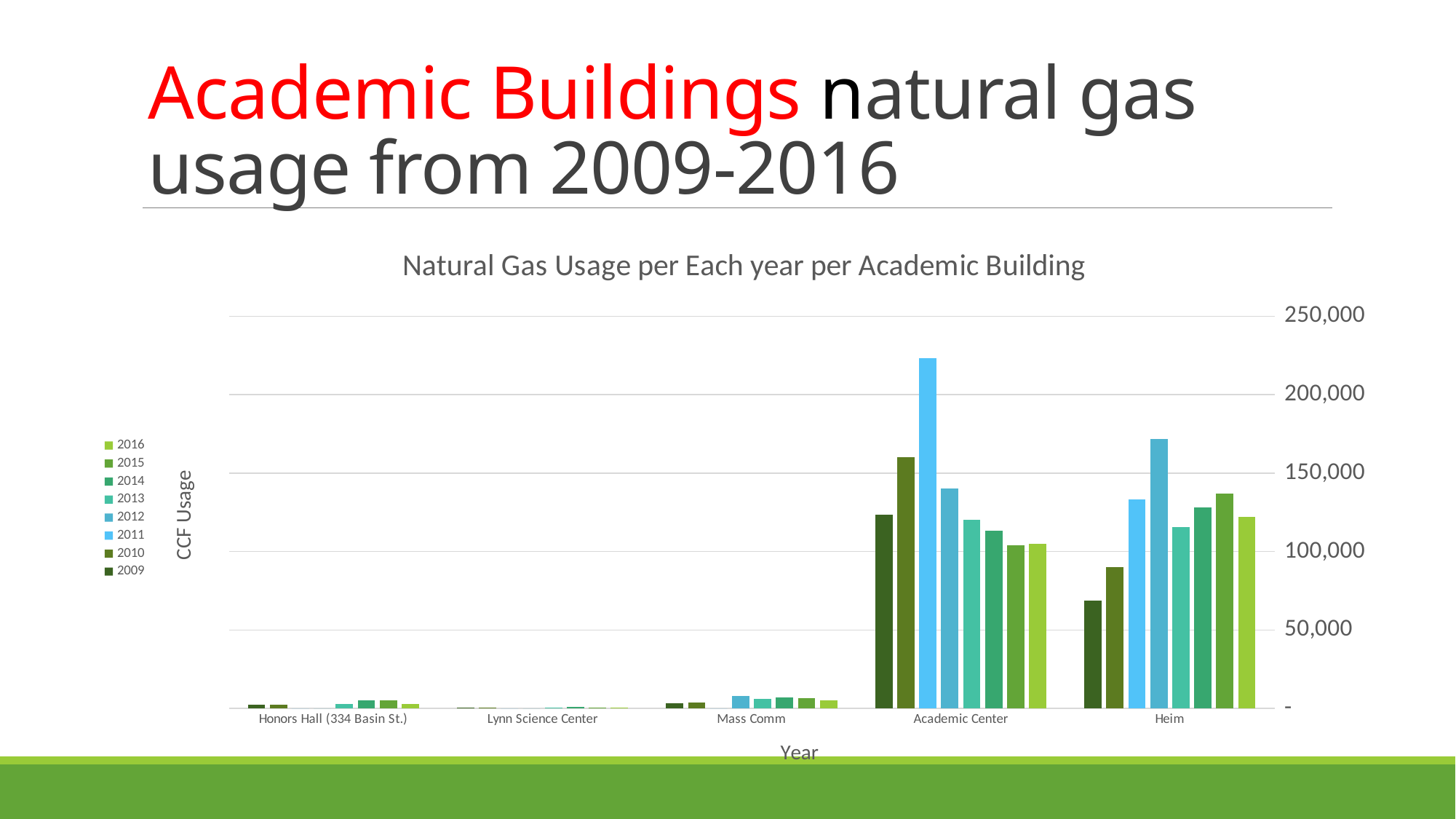
What is the title of the chart? Natural Gas Usage per Each year per Academic Building What kind of chart is shown on the slide? bar chart Which is larger, the 2011 value for Academic Center or the 2011 value for Heim? Academic Center Which is larger for Heim, the 2009 value or the 2015 value? 2015 What is the label on the vertical axis? CCF Usage Is the 2010 value for Heim greater or less than 100,000? less Which building has the tallest bar in the chart? Academic Center Is the 2012 value for Heim greater or less than 150,000? greater Which building has the lowest natural gas usage across all years? Lynn Science Center How many buildings (categories) are shown on the x axis? 5 How many series (years) does the legend list? 8 Is the 2011 value for Academic Center greater or less than 200,000? greater